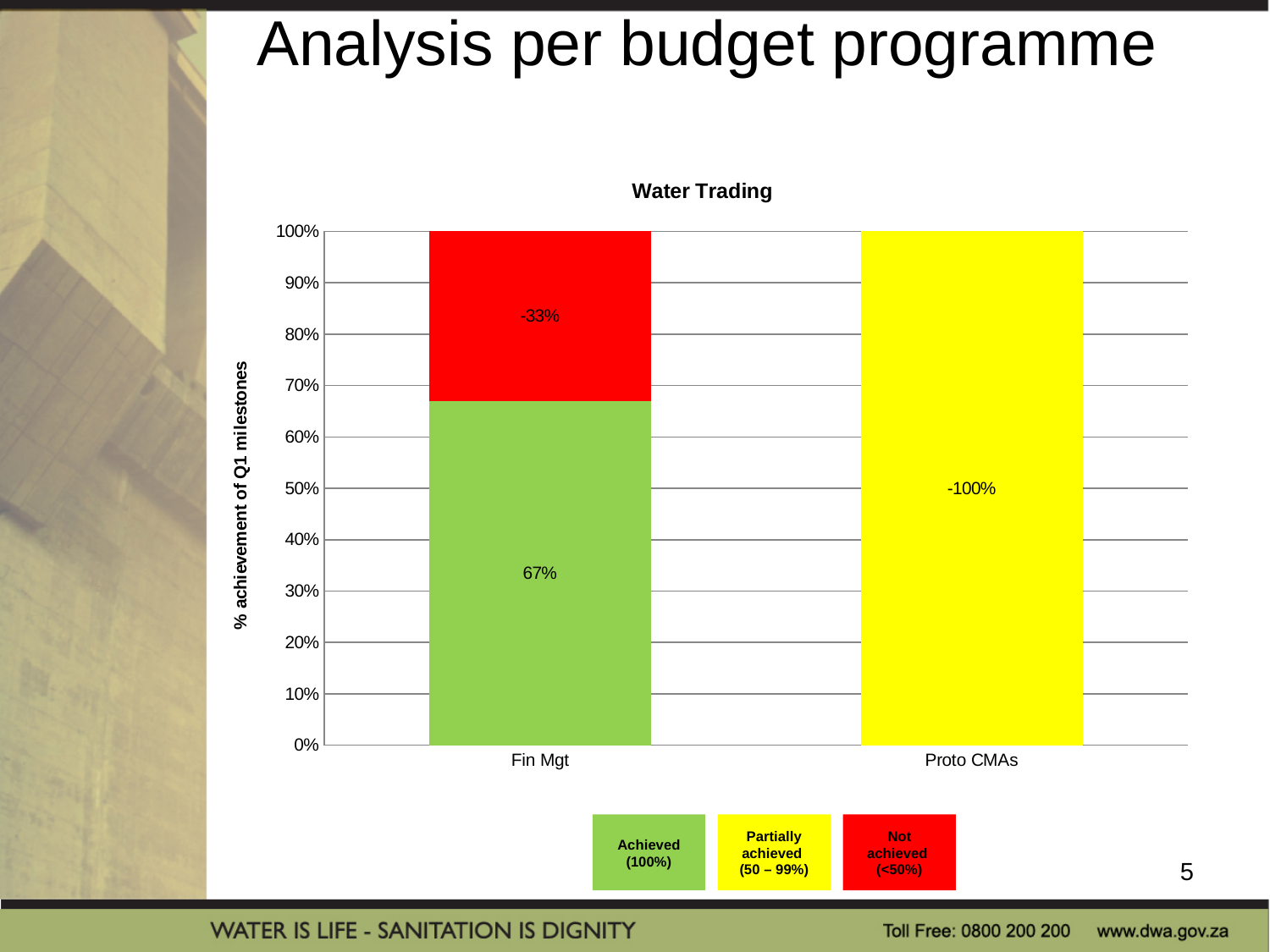
Is the green (Achieved) segment for Fin Mgt greater or less than 50%? greater What is the y-axis title of the chart? % achievement of Q1 milestones How many budget programmes (categories) are shown on the x axis of the chart? 2 What is the data label on the red segment of the Fin Mgt bar? -33% What type of chart is shown under the title "Water Trading"? stacked bar chart What is the data label on the yellow bar for Proto CMAs? -100% Which category's bar is entirely yellow (Partially achieved)? Proto CMAs Which category has the larger green (Achieved) segment, Fin Mgt or Proto CMAs? Fin Mgt What is the title of the chart? Water Trading What is the data label on the green segment of the Fin Mgt bar? 67% What is the maximum value shown on the y axis of the chart? 100% Is the red (Not achieved) segment for Fin Mgt greater or less than 40%? less